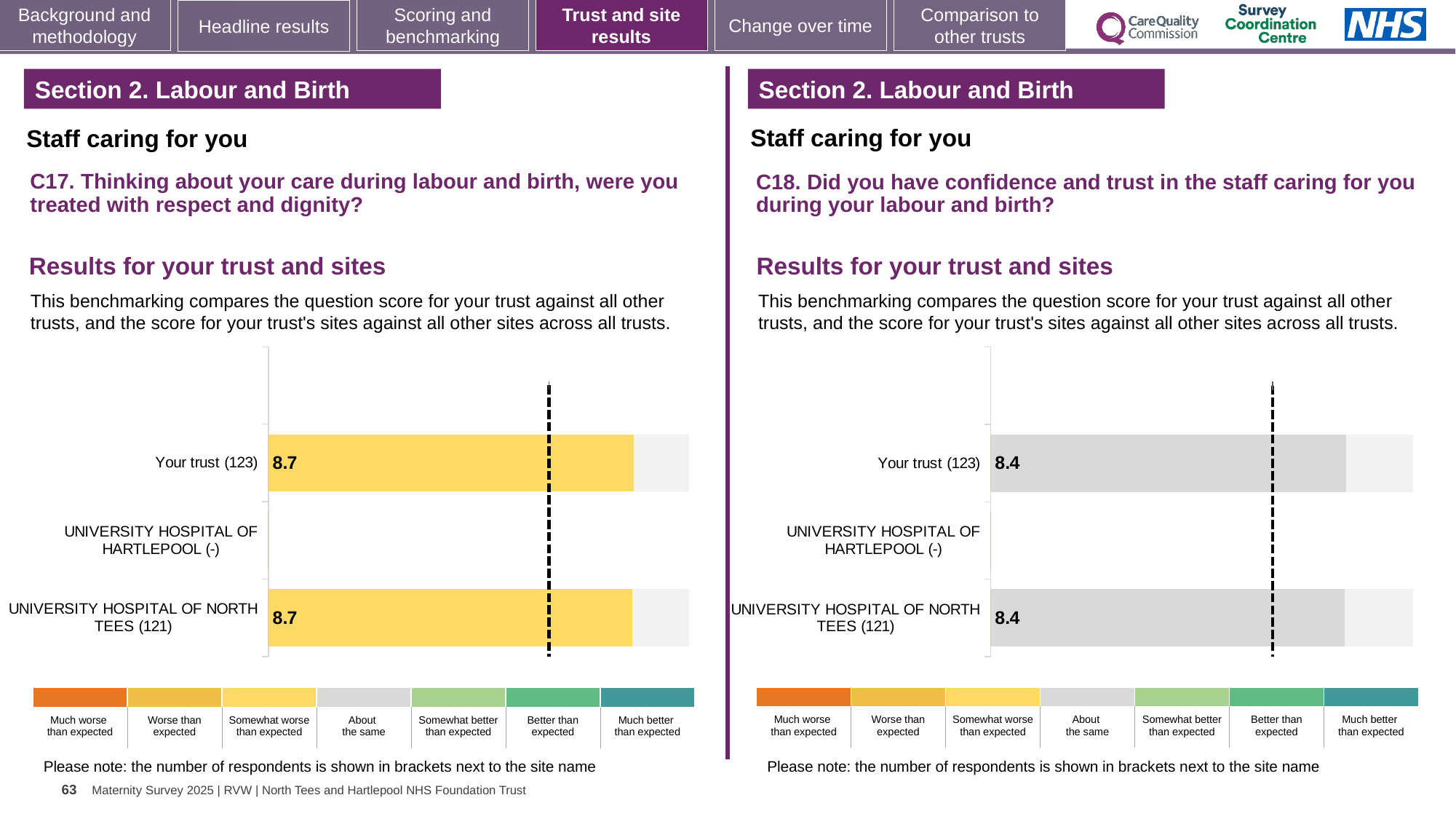
In the left chart (C17), which category has no bar or score shown? UNIVERSITY HOSPITAL OF HARTLEPOOL (-) In the right chart (C18), what is the score for UNIVERSITY HOSPITAL OF NORTH TEES (121)? 8.4 In the left chart (C17), what is the score for Your trust (123)? 8.7 In the right chart (C18), how many bars have a score printed? 2 In the left chart (C17), what is the score for UNIVERSITY HOSPITAL OF NORTH TEES (121)? 8.7 How many categories (rows) are listed on the right chart (C18)? 3 In the left chart (C17), is the score for Your trust (123) greater or less than the score for UNIVERSITY HOSPITAL OF NORTH TEES (121), or are they equal? Equal In the right chart (C18), which benchmark category does the grey colour of the bars correspond to in the legend? About the same What kind of chart is used on the right (C18)? Bar chart How many categories (rows) are listed on the left chart (C17)? 3 What kind of chart is used on the left (C17)? Bar chart In the right chart (C18), what is the score for Your trust (123)? 8.4